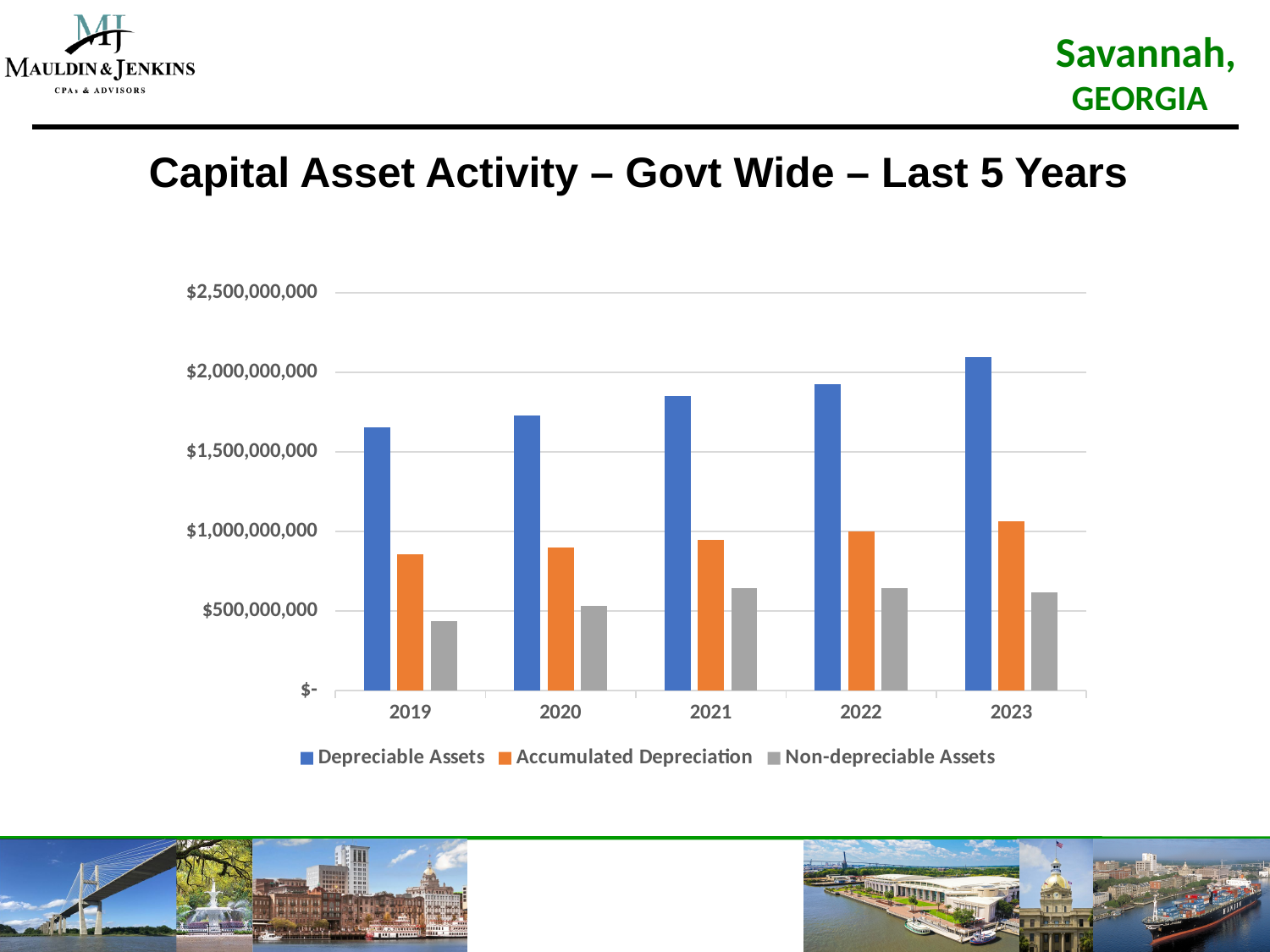
Is the Accumulated Depreciation value for 2019 greater or less than $1,000,000,000? less What kind of chart is shown on the slide? bar chart How many years are shown on the x axis? 5 In which year is the Non-depreciable Assets value lowest? 2019 Is the Non-depreciable Assets value for 2019 greater or less than $500,000,000? less Do the Depreciable Assets values rise or fall from 2019 to 2023? rise Is the Depreciable Assets value for 2019 greater or less than $1,500,000,000? greater In which year is the Depreciable Assets value highest? 2023 Which series is shown in orange in the legend? Accumulated Depreciation How many series does the legend list? 3 In 2023, which is larger: Depreciable Assets or Accumulated Depreciation? Depreciable Assets